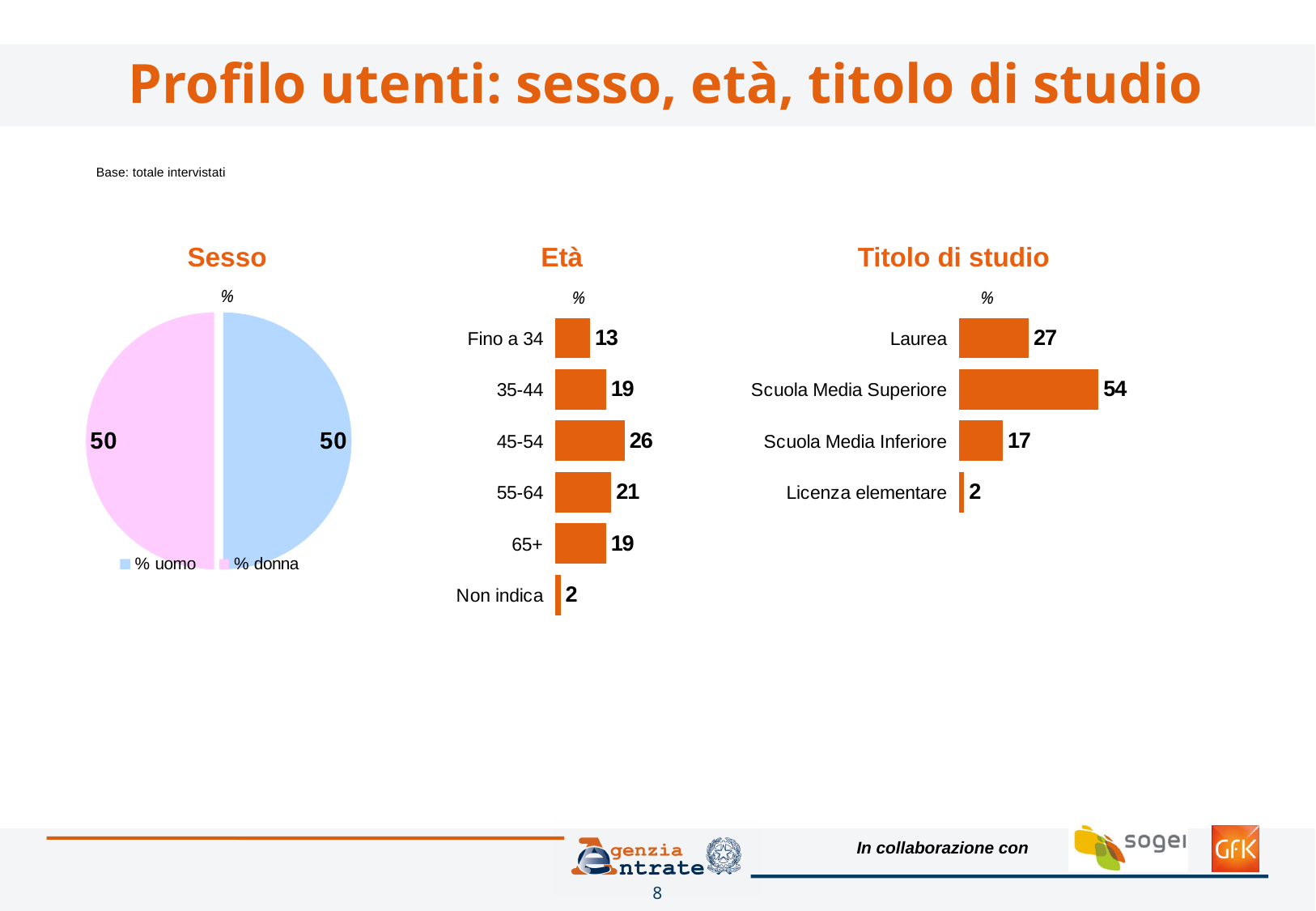
In the 'Età' chart, how many categories are shown? 6 In the 'Titolo di studio' chart, what is the value for 'Laurea'? 27 In the 'Età' chart, what is the difference between '55-64' and 'Fino a 34'? 8 In the 'Sesso' chart, how many entries does the legend list? 2 In the 'Sesso' chart, what is the value for '% uomo'? 50 In the 'Titolo di studio' chart, which category has the highest value? Scuola Media Superiore In the 'Età' chart, which category has the lowest value? Non indica In the 'Età' chart, which category has the highest value? 45-54 In the 'Titolo di studio' chart, what kind of chart is shown? bar chart In the 'Titolo di studio' chart, which is larger, 'Laurea' or 'Scuola Media Inferiore'? Laurea In the 'Età' chart, what is the value for '45-54'? 26 In the 'Sesso' chart, what kind of chart is shown? pie chart